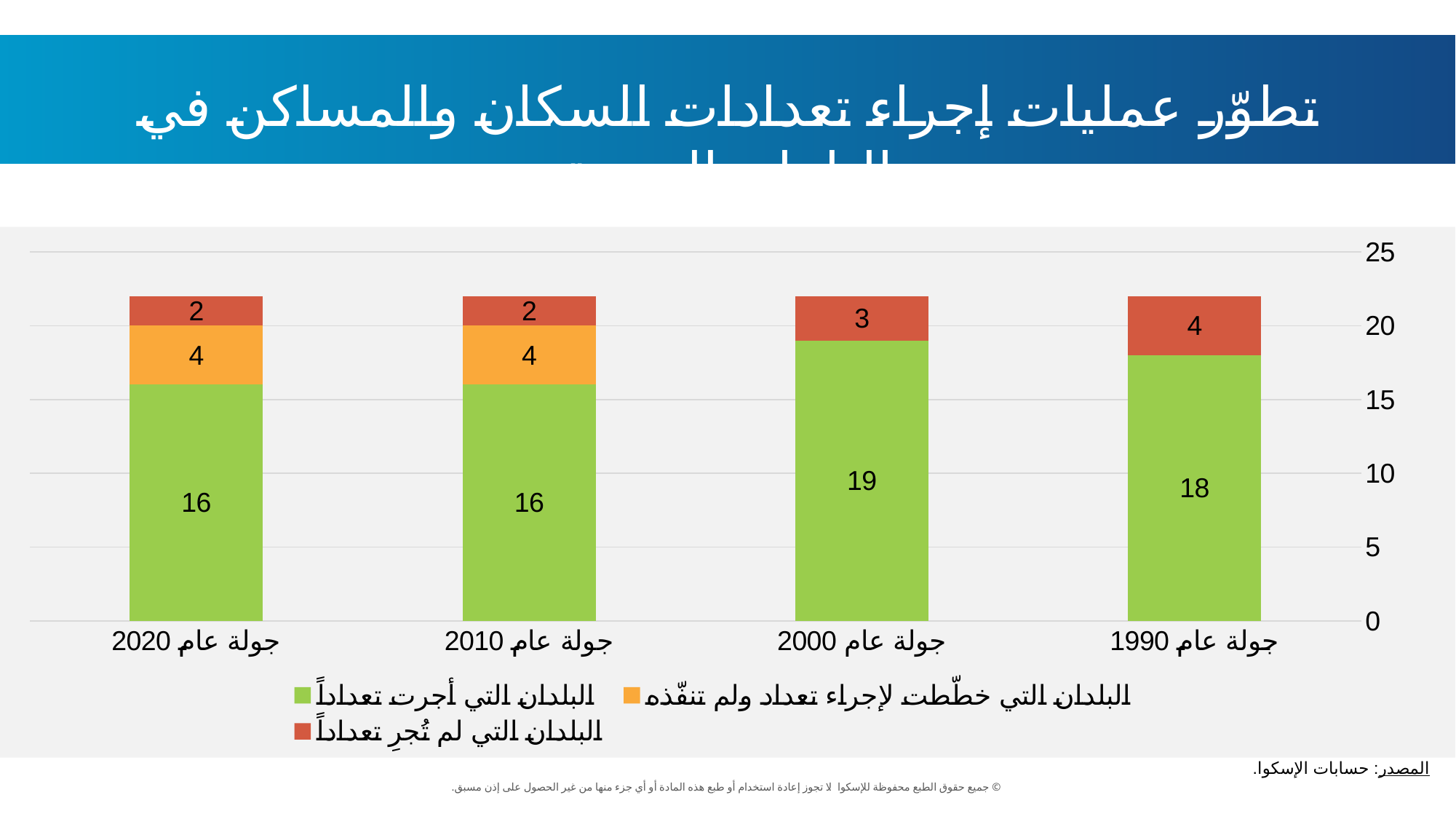
In which round is the red series (البلدان التي لم تُجرِ تعداداً) highest? جولة عام 1990 What is the total of the stacked bar for جولة عام 2010? 22 In which round is the green series (البلدان التي أجرت تعداداً) highest? جولة عام 2000 What is the value for the green series (البلدان التي أجرت تعداداً) in جولة عام 1990? 18 What is the value for the red series (البلدان التي لم تُجرِ تعداداً) in جولة عام 2000? 3 How many series does the legend list? 3 What kind of chart is shown on the slide? Stacked bar chart What is the total of the stacked bar for جولة عام 1990? 22 Which is larger: the red series value in جولة عام 1990 or in جولة عام 2010? جولة عام 1990 How many census rounds (categories) are shown on the x axis? 4 What is the difference between the green series values for جولة عام 2000 and جولة عام 2020? 3 What is the value for the orange series (البلدان التي خطّطت لإجراء تعداد ولم تنفّذه) in جولة عام 2010? 4